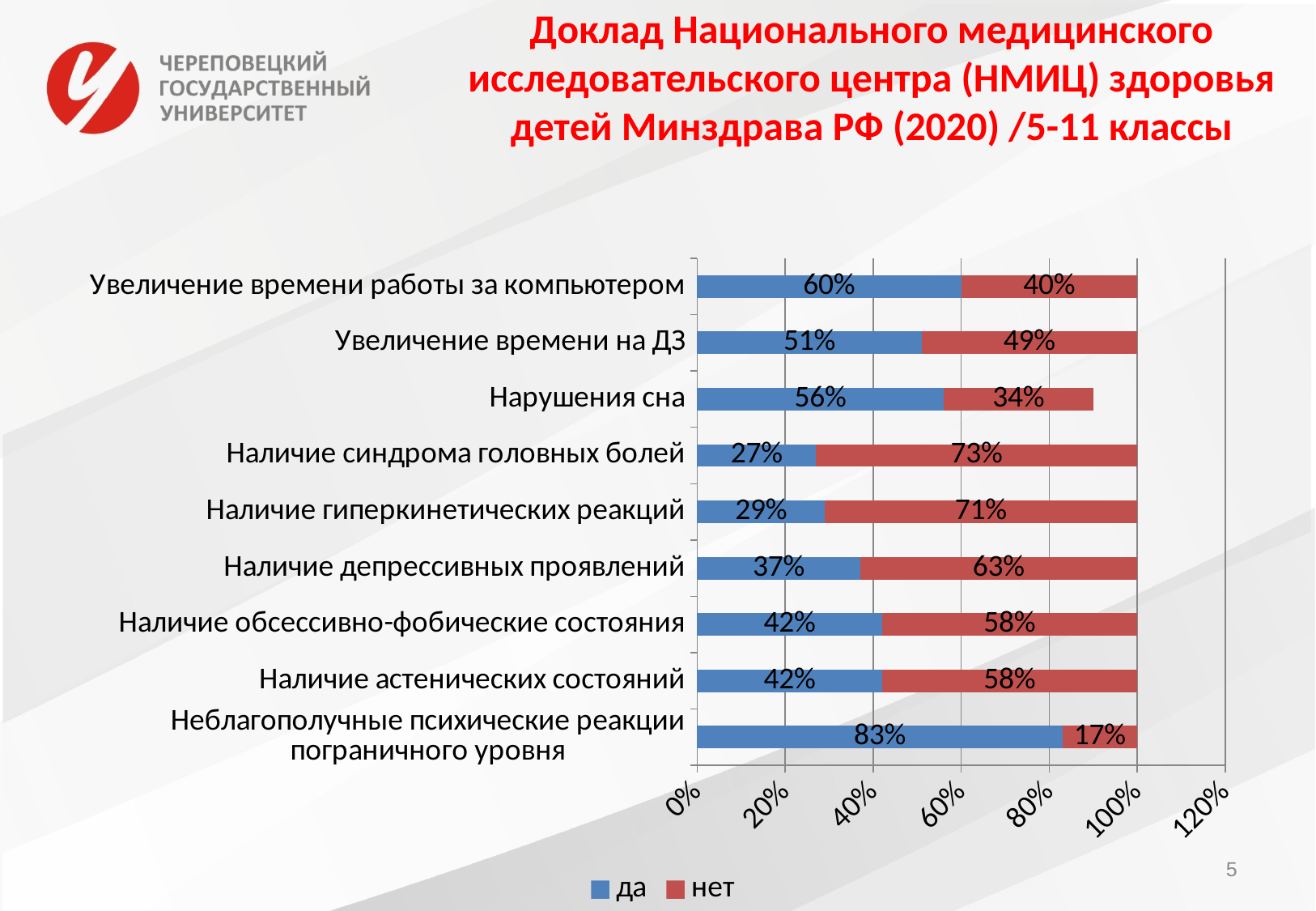
What is the value of the "да" series for "Неблагополучные психические реакции пограничного уровня"? 83% How many categories are shown on the chart? 9 What are the two entries in the chart legend? да and нет What kind of chart is shown on the slide? Stacked bar chart What is the total of the stacked bar for "Нарушения сна"? 90% Which category has the highest "да" value? Неблагополучные психические реакции пограничного уровня Which is larger for "Увеличение времени на ДЗ": the "да" value or the "нет" value? да What is the difference between the "нет" and "да" values for "Наличие депрессивных проявлений"? 26% What is the value of the "да" series for "Увеличение времени работы за компьютером"? 60% What is the value of the "нет" series for "Наличие синдрома головных болей"? 73% How many series does the legend list? 2 Which category has the lowest "да" value? Наличие синдрома головных болей